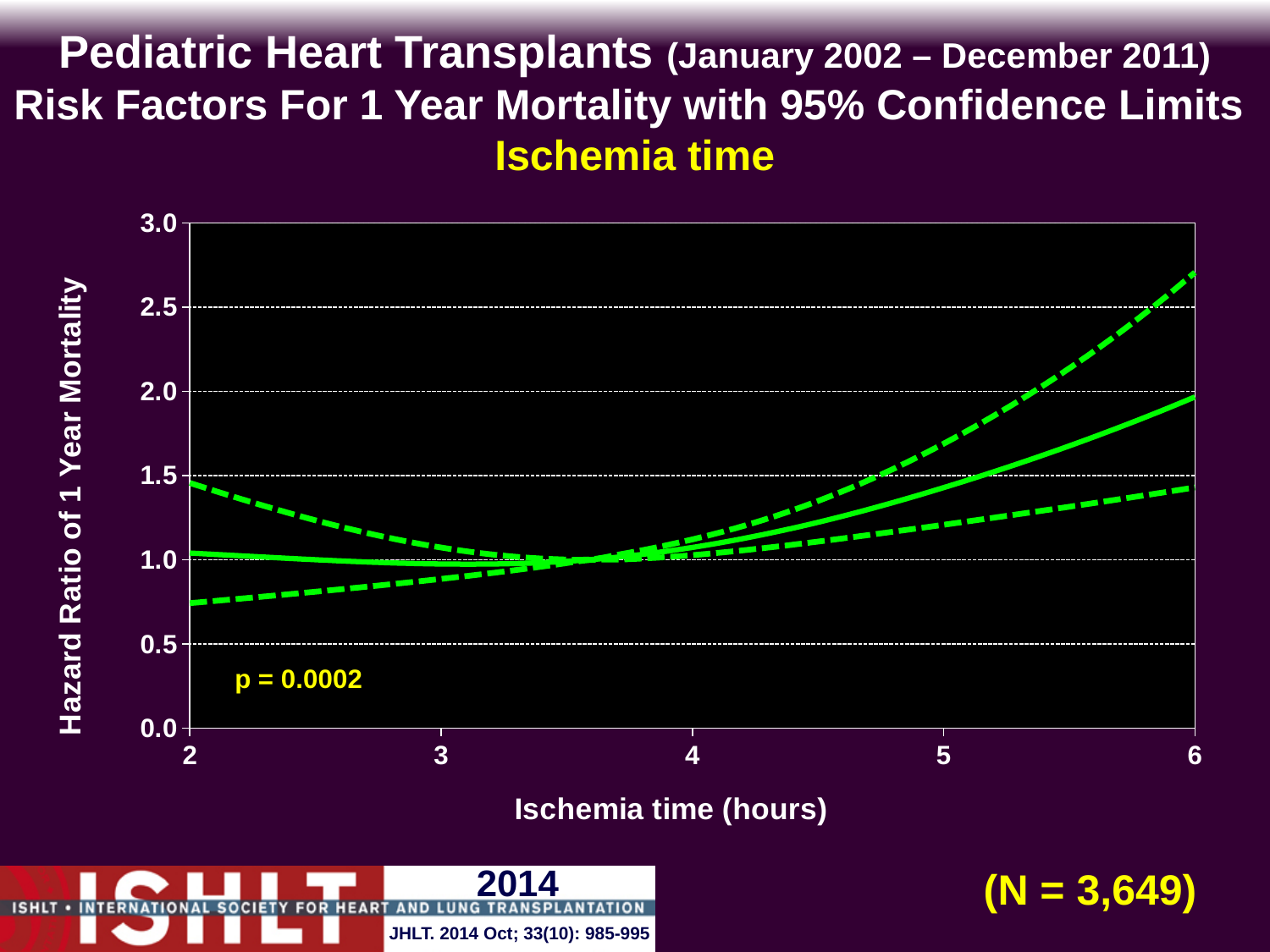
Does the upper dashed confidence limit rise or fall between 2 and 3 hours of ischemia time? fall What is the label of the x axis? Ischemia time (hours) What is the label of the y axis? Hazard Ratio of 1 Year Mortality What p-value is printed on the chart? p = 0.0002 Is the value of the lower dashed confidence limit at 6 hours greater or less than 1.5? less Is the value of the lower dashed confidence limit at 2 hours greater or less than 1.0? less How many lines are plotted on the chart? 3 Is the value of the solid hazard ratio line at 6 hours greater or less than 1.5? greater What kind of chart is shown on the slide? line chart Does the solid hazard ratio line rise or fall between 4 and 6 hours of ischemia time? rise What sample size (N) is shown on the slide? N = 3,649